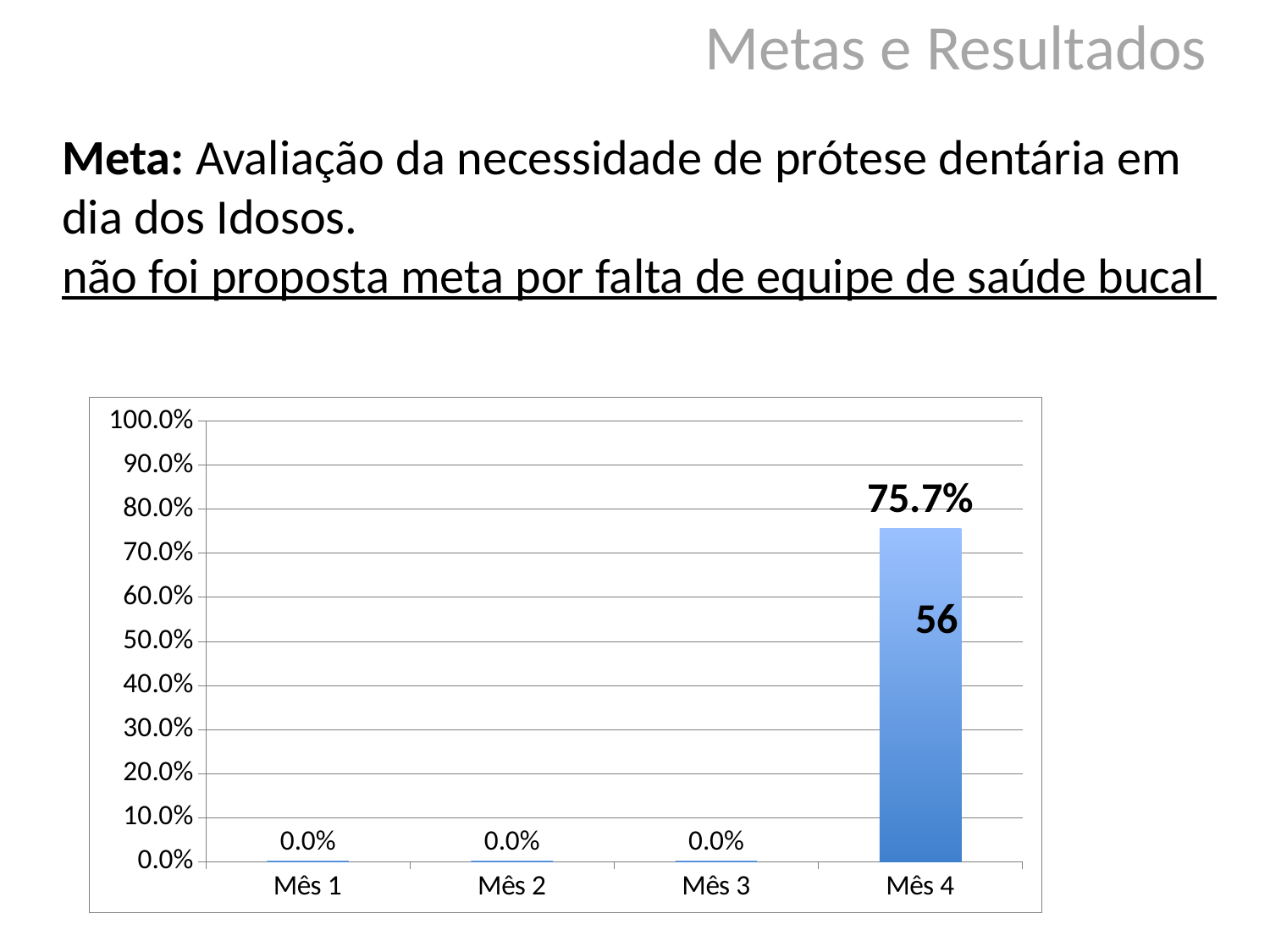
What is the value for Mês 1? 0.0% What is the highest value shown on the y axis? 100.0% What is the value for Mês 4? 75.7% Which is larger, the value for Mês 2 or the value for Mês 4? Mês 4 How many months are shown on the x axis? 4 What kind of chart is shown on the slide? bar chart What is the value for Mês 3? 0.0% Do the values rise or fall from Mês 3 to Mês 4? rise What number is printed inside the bar for Mês 4? 56 What is the difference between the values for Mês 4 and Mês 3? 75.7% Is the value for Mês 4 greater or less than 70.0%? greater Which month has the highest value? Mês 4